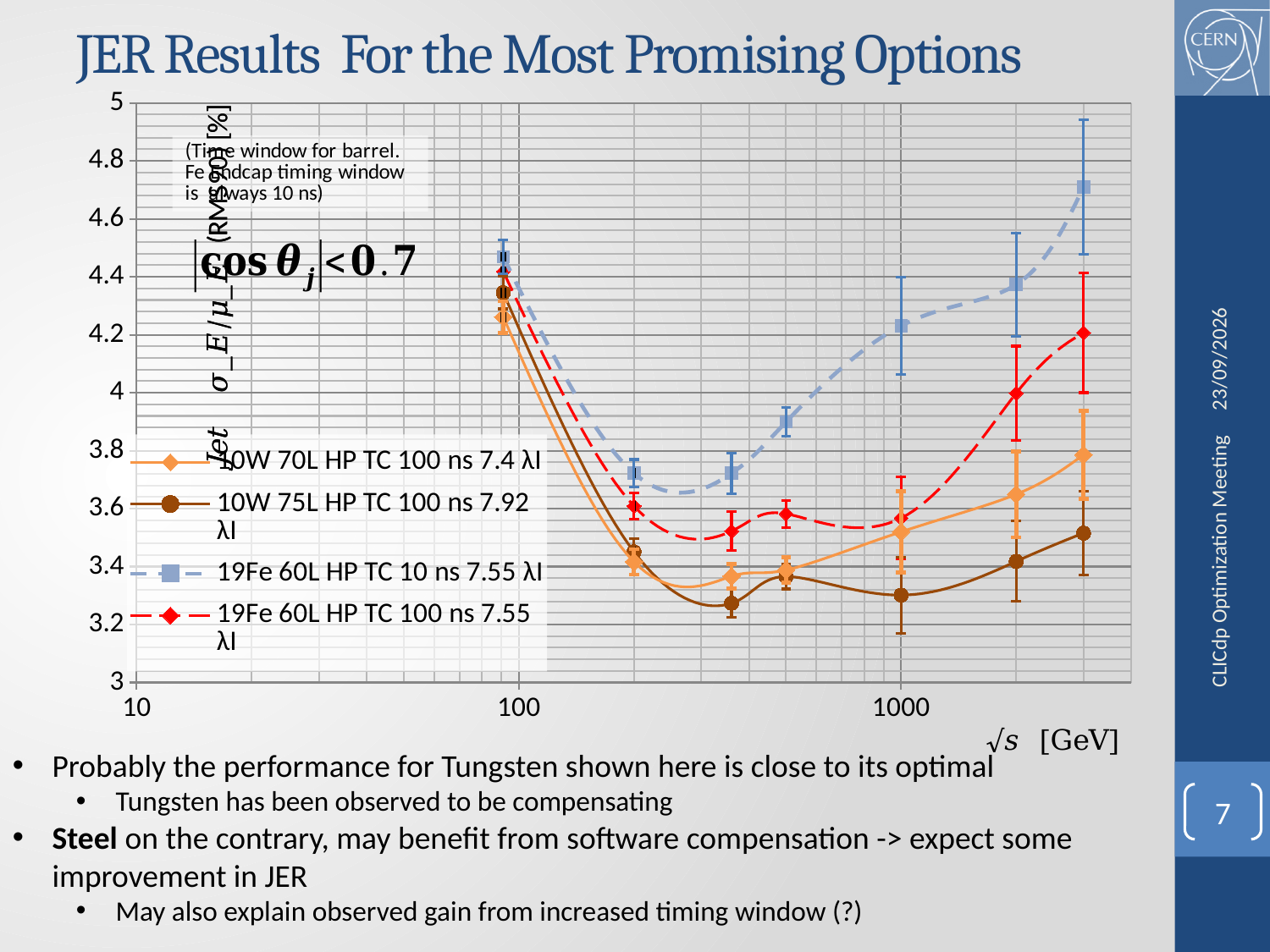
What is the label of the x axis of the chart? √s [GeV] Is the value for 19Fe 60L HP TC 10 ns 7.55 λI at 1000 GeV greater or less than 4? greater Which series has the lowest value at the rightmost data point? 10W 75L HP TC 100 ns 7.92 λI Which series has the highest value at the rightmost data point? 19Fe 60L HP TC 10 ns 7.55 λI Is the value for 10W 75L HP TC 100 ns 7.92 λI at 1000 GeV greater or less than 3.4? less Between 1000 GeV and the rightmost data point, does the 19Fe 60L HP TC 10 ns 7.55 λI series rise or fall? rise How many series does the chart legend list? 4 Which series in the legend is drawn in brown with circle markers? 10W 75L HP TC 100 ns 7.92 λI Is the value for 19Fe 60L HP TC 10 ns 7.55 λI at its rightmost data point greater or less than 4.4? greater How many data points are plotted for each series? 7 What kind of chart is shown on the slide? line chart At 1000 GeV, which is larger: the value for 19Fe 60L HP TC 10 ns 7.55 λI or the value for 10W 75L HP TC 100 ns 7.92 λI? 19Fe 60L HP TC 10 ns 7.55 λI